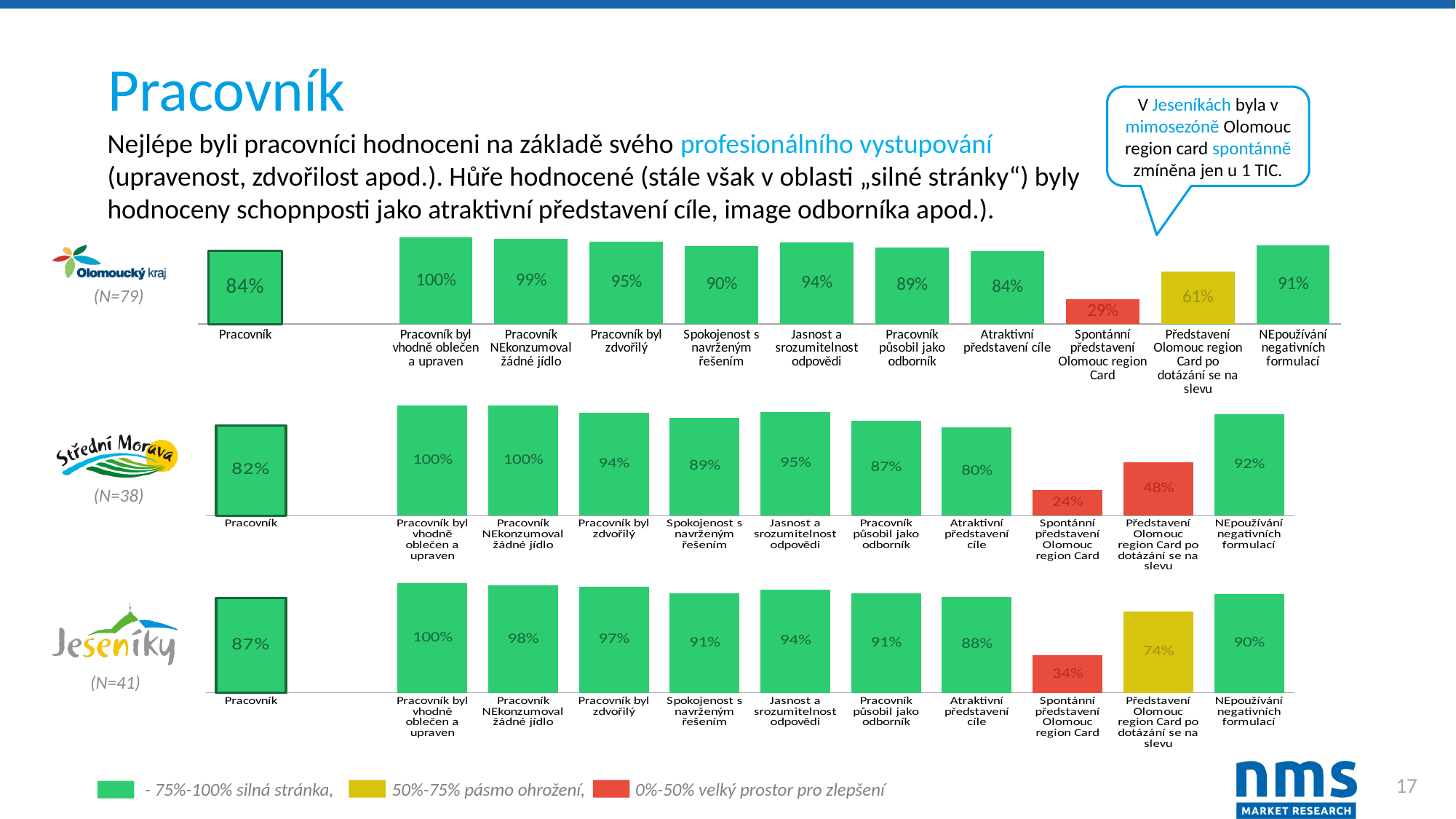
In the top chart (Olomoucký kraj, N=79), which category has the highest value? Pracovník byl vhodně oblečen a upraven In the middle chart (Střední Morava, N=38), what is the value for "Představení Olomouc region Card po dotázání se na slevu"? 48% In the bottom chart (Jeseníky, N=41), which category has the lowest value? Spontánní představení Olomouc region Card In the top chart (Olomoucký kraj, N=79), what is the value for "Představení Olomouc region Card po dotázání se na slevu"? 61% In the top chart (Olomoucký kraj, N=79), what is the value for "Spontánní představení Olomouc region Card"? 29% In the bottom chart (Jeseníky, N=41), which is larger: "Pracovník byl zdvořilý" or "Jasnost a srozumitelnost odpovědi"? Pracovník byl zdvořilý What type of chart is used for the Střední Morava (N=38) data? Bar chart In the bottom chart (Jeseníky, N=41), what is the value for "Pracovník"? 87% How many bars are shown in the top chart (Olomoucký kraj, N=79)? 11 In the middle chart (Střední Morava, N=38), what is the value for "Spontánní představení Olomouc region Card"? 24% According to the legend at the bottom, what range of values does the yellow colour represent? 50%-75% pásmo ohrožení In the middle chart (Střední Morava, N=38), what is the difference between "NEpoužívání negativních formulací" and "Atraktivní představení cíle"? 12%